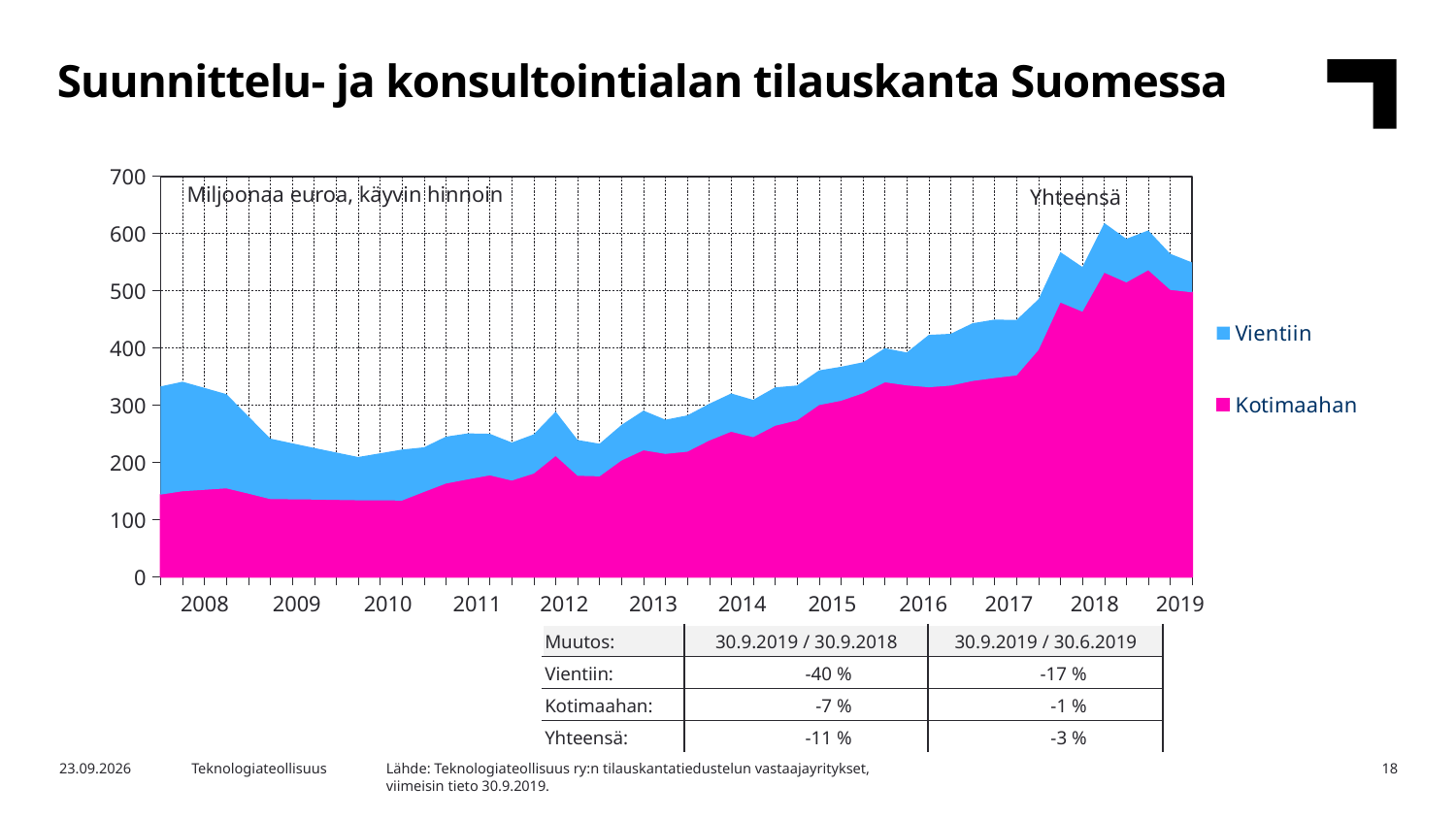
How many years are labelled on the x axis of the chart? 12 According to the table below the chart, what is the change in Vientiin for 30.9.2019 / 30.9.2018? -40 % Is the Kotimaahan value at the start of 2008 greater or less than 200? less What kind of chart is shown on the slide? Stacked area chart Does the Kotimaahan series rise or fall between 2010 and 2018? rises How many series does the chart legend list? 2 What are the two series named in the chart legend? Vientiin and Kotimaahan Which series is larger at the end of 2019, Vientiin or Kotimaahan? Kotimaahan In which year does the total (Yhteensä) order book reach its highest level? 2018 Is the Kotimaahan value at its 2018 peak greater or less than 500? greater What unit is stated in the label at the top left of the chart area? Miljoonaa euroa, käyvin hinnoin Is the total (Yhteensä) value at the start of 2008 greater or less than 300? greater